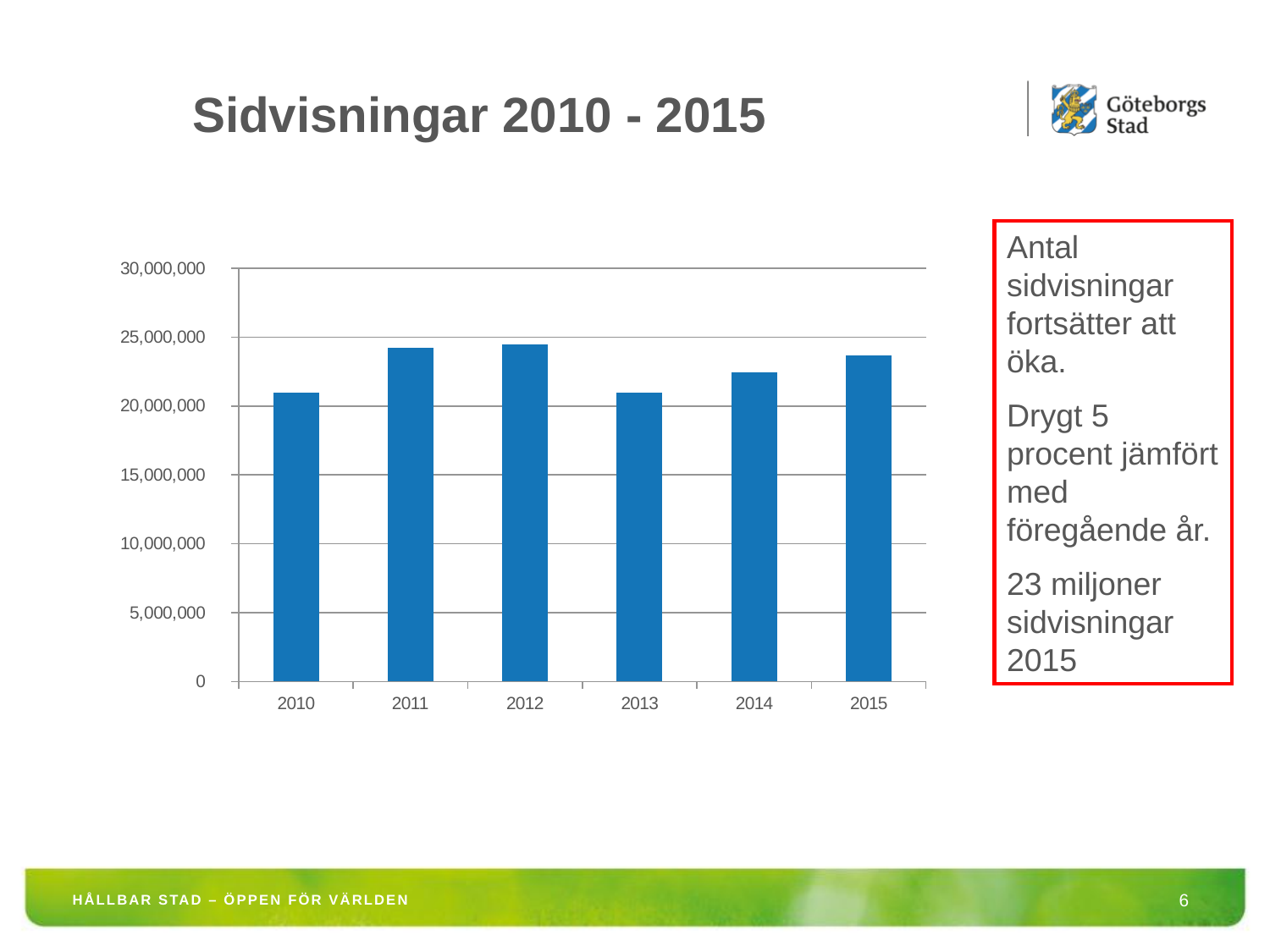
Is the value for 2010 greater or less than 20,000,000? greater Which year has the larger value, 2010 or 2011? 2011 Is the value for 2014 greater or less than 20,000,000? greater Is the value for 2011 greater or less than 25,000,000? less What kind of chart is shown on the slide? bar chart What is the highest value shown on the y axis of the chart? 30,000,000 Which year has the larger value, 2012 or 2013? 2012 Which year has the larger value, 2014 or 2015? 2015 Do the values rise or fall from 2013 to 2015? rise How many years are shown on the x axis of the chart? 6